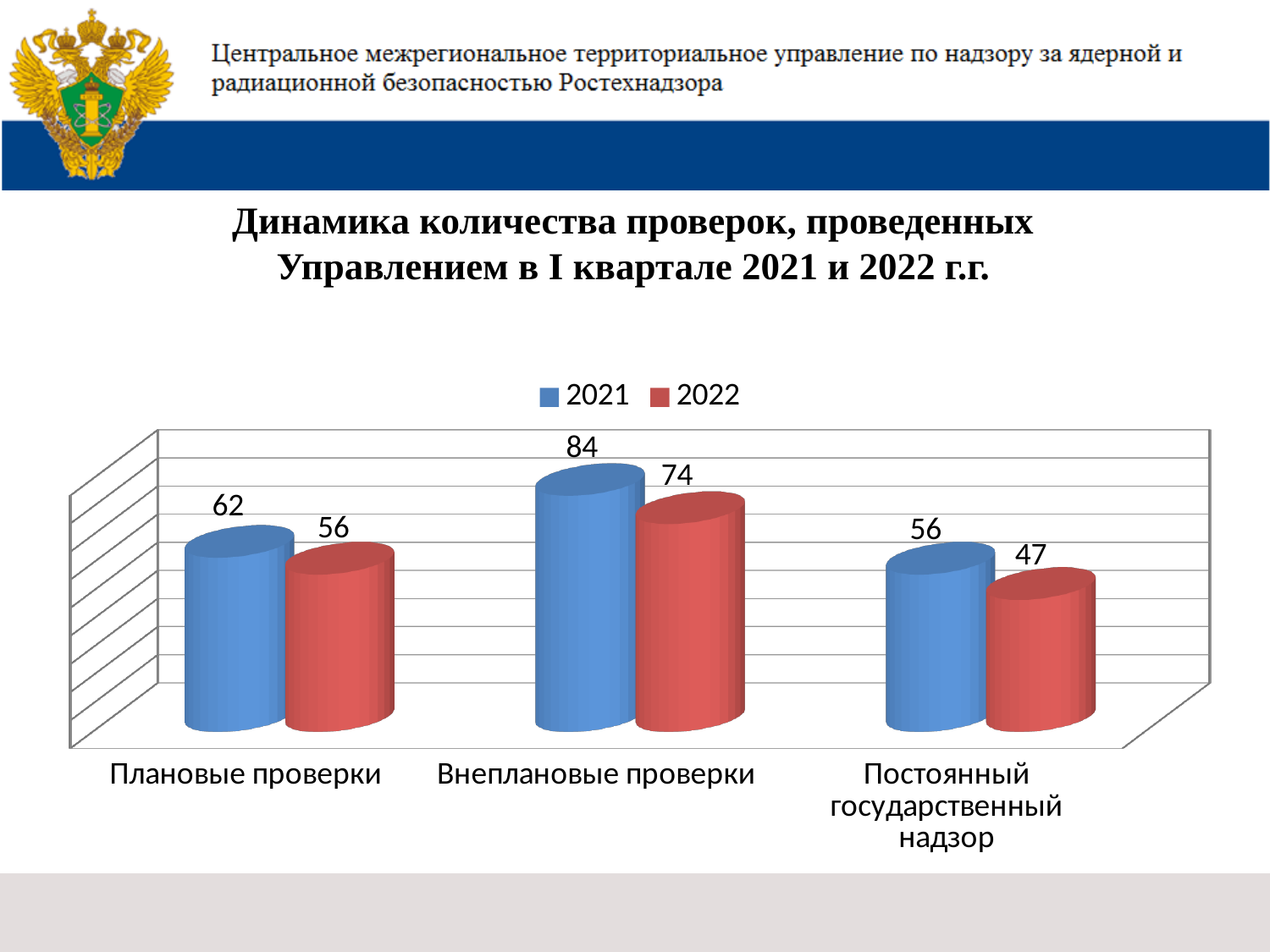
What is the value for Плановые проверки in 2021? 62 Which is larger: the 2021 value for Плановые проверки or the 2022 value for Плановые проверки? 2021 What kind of chart is shown on the slide? bar chart Which category has the lowest value for 2022? Постоянный государственный надзор What is the value for Постоянный государственный надзор in 2022? 47 How many series does the legend list? 2 How many categories are shown on the x axis? 3 Which category has the highest value for 2021? Внеплановые проверки What is the difference between the 2021 and 2022 values for Внеплановые проверки? 10 Which colour represents the 2022 series? red What is the difference between the 2021 and 2022 values for Постоянный государственный надзор? 9 What is the value for Внеплановые проверки in 2022? 74